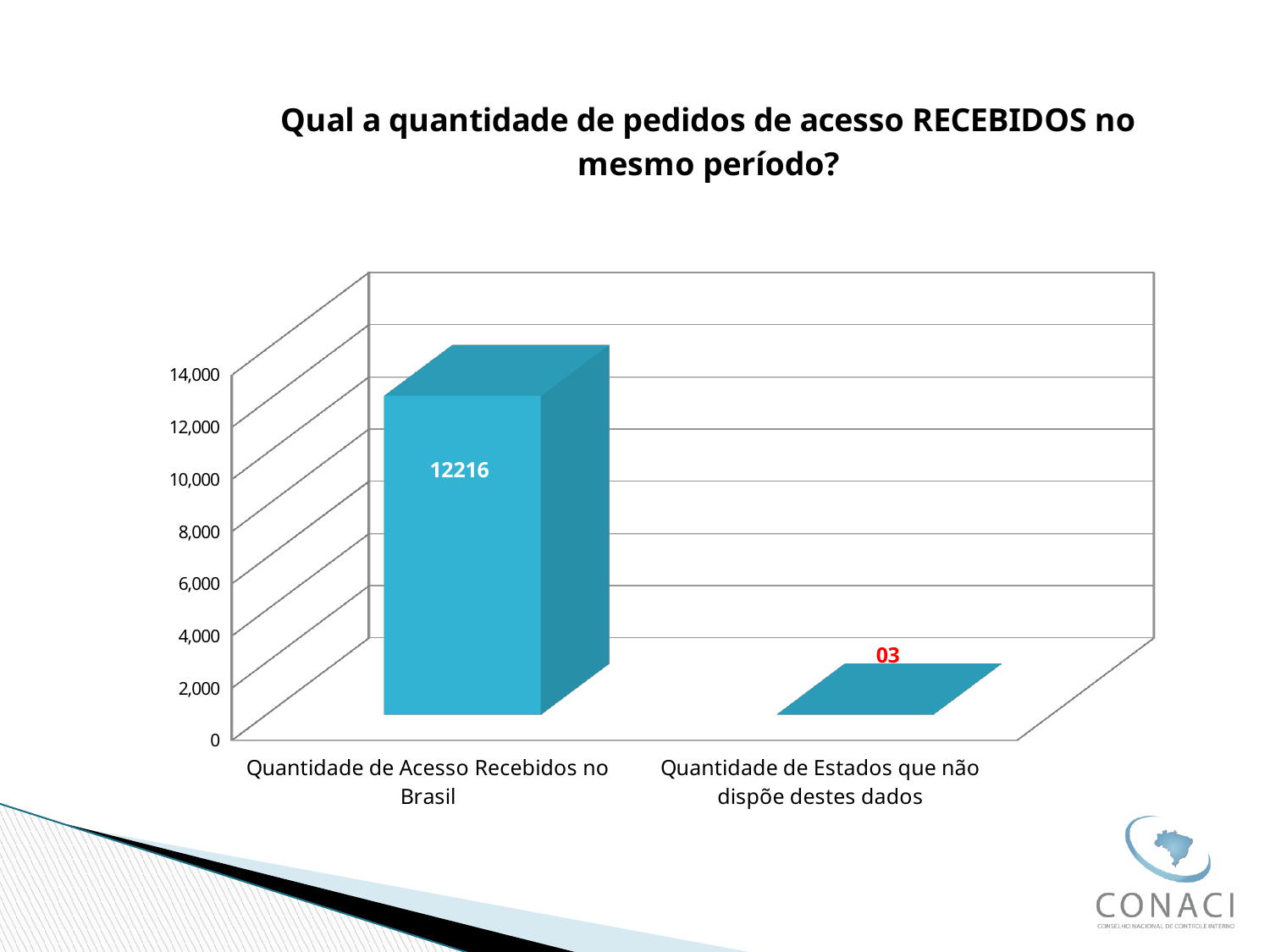
How many categories are shown on the chart? 2 Is the value for "Quantidade de Estados que não dispõe destes dados" greater or less than 2,000? less What kind of chart is shown on the slide? bar chart What is the difference between the value for "Quantidade de Acesso Recebidos no Brasil" and the value for "Quantidade de Estados que não dispõe destes dados"? 12213 Is the value for "Quantidade de Acesso Recebidos no Brasil" greater or less than 10,000? greater What is the highest value labelled on the vertical axis? 14,000 What is the value for "Quantidade de Estados que não dispõe destes dados"? 03 What is the value for "Quantidade de Acesso Recebidos no Brasil"? 12216 Which category has the lowest value? Quantidade de Estados que não dispõe destes dados Which category has the highest value? Quantidade de Acesso Recebidos no Brasil Which is larger: the value for "Quantidade de Acesso Recebidos no Brasil" or the value for "Quantidade de Estados que não dispõe destes dados"? Quantidade de Acesso Recebidos no Brasil What is the title of the chart? Qual a quantidade de pedidos de acesso RECEBIDOS no mesmo período?